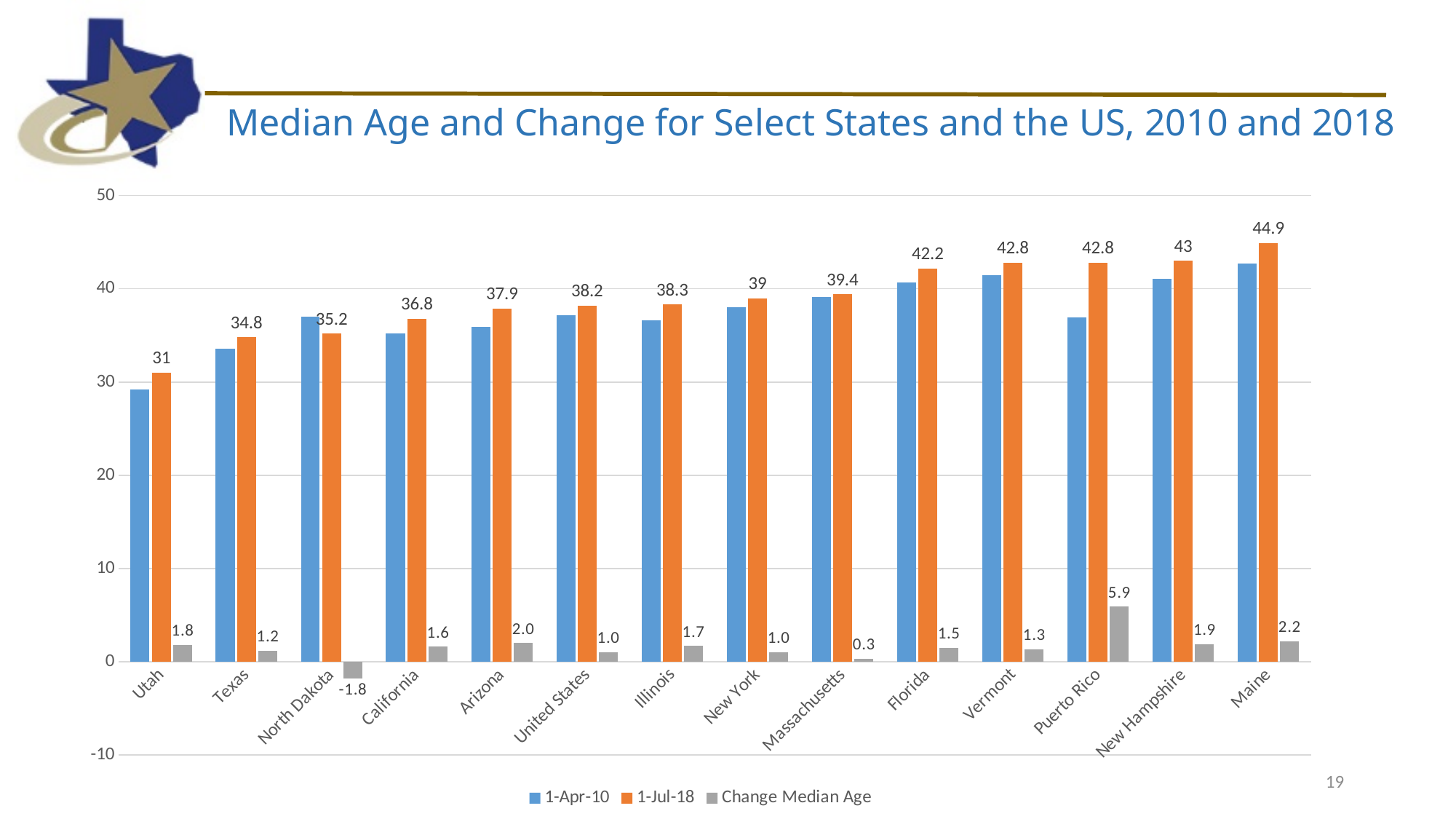
What is the Change Median Age value for Puerto Rico? 5.9 What kind of chart is shown on the slide? bar chart How many categories (states/areas) are shown on the x axis? 14 Is the 1-Apr-10 value for Maine greater or less than 40? greater Which category has the lowest Change Median Age value? North Dakota Which category has the highest 1-Jul-18 median age? Maine How many series does the legend list? 3 What is the difference between the 1-Jul-18 median age for Maine and for Utah? 13.9 Do the 1-Jul-18 median age values rise or fall from left to right along the x axis? rise What is the Change Median Age value for Massachusetts? 0.3 Which has a larger 1-Jul-18 median age, Florida or Vermont? Vermont What is the 1-Jul-18 median age value for Texas? 34.8